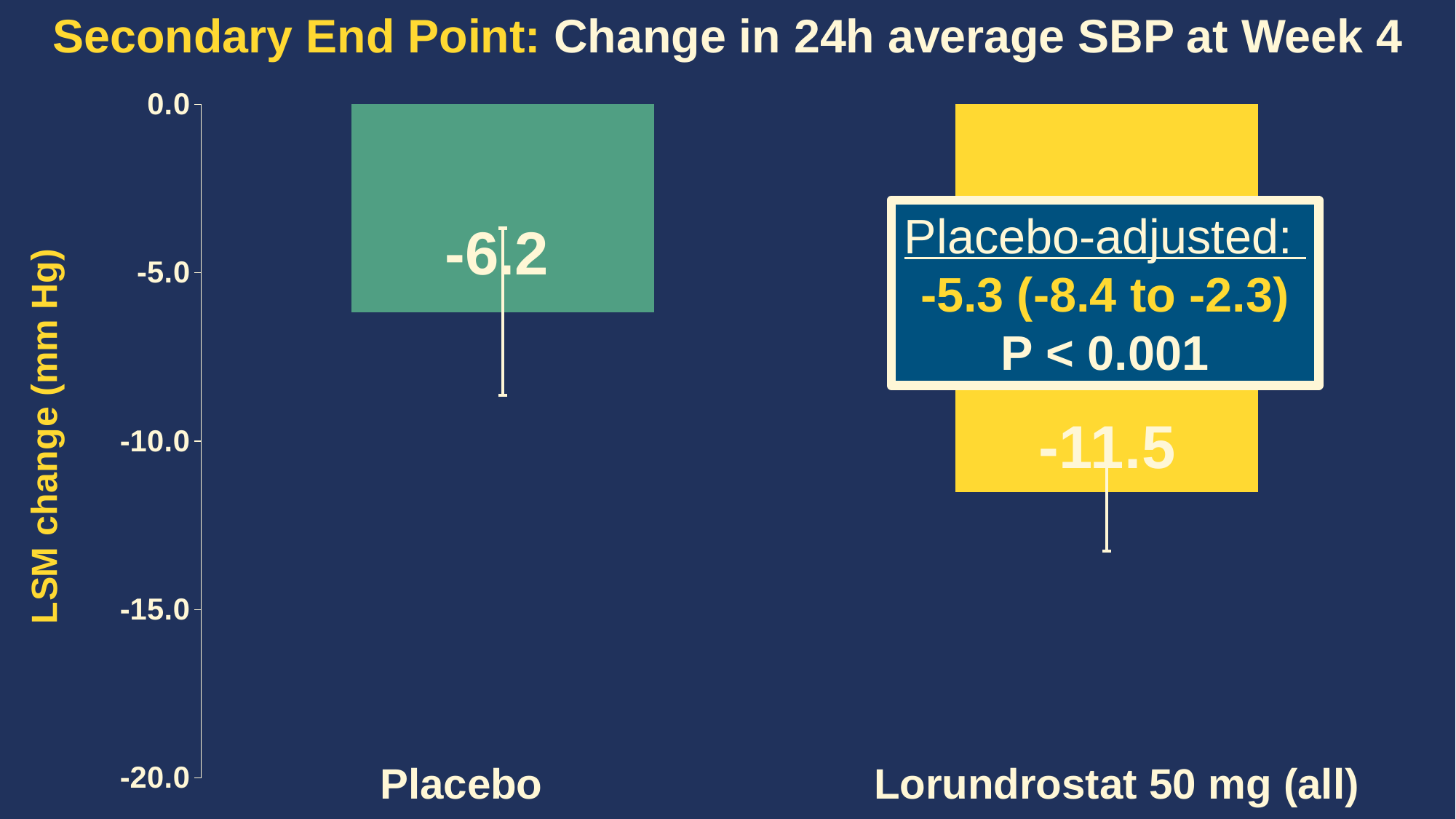
What is the placebo-adjusted change shown in the callout box? -5.3 (-8.4 to -2.3) What kind of chart is shown on the slide? Bar chart Which category has the lowest (most negative) LSM change value? Lorundrostat 50 mg (all) How many categories are shown on the chart? 2 Is the value for Lorundrostat 50 mg (all) greater or less than -10.0? less What is the LSM change in 24h average SBP for Placebo? -6.2 What is the difference between the Placebo and Lorundrostat 50 mg (all) LSM change values? 5.3 Which group shows the larger reduction in 24h average SBP? Lorundrostat 50 mg (all) Which category has the highest (least negative) LSM change value? Placebo What is the LSM change in 24h average SBP for Lorundrostat 50 mg (all)? -11.5 Is the value for Placebo greater or less than -10.0? greater What is the label of the y axis? LSM change (mm Hg)